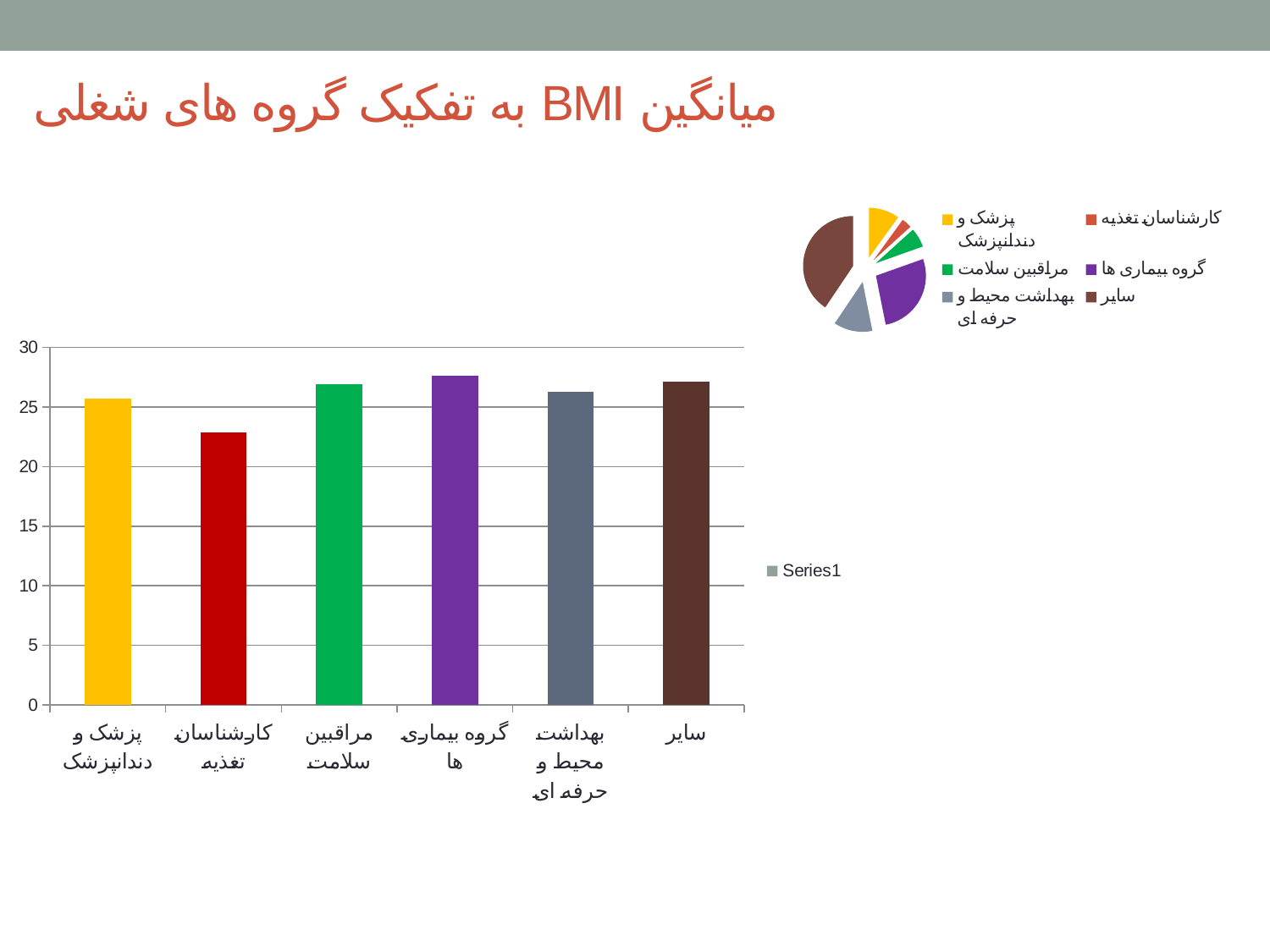
What is the title of the slide? میانگین BMI به تفکیک گروه های شغلی What kind of chart is the small chart in the upper right of the slide? pie chart In the bar chart, is the value for گروه بیماری ها greater or less than 25? greater In the bar chart, how many occupational groups are shown on the x axis? 6 In the bar chart, how many series does the legend list? 1 In the bar chart, which is larger: the value for کارشناسان تغذیه or the value for مراقبین سلامت? مراقبین سلامت In the pie chart, which legend entry corresponds to the largest slice? سایر In the bar chart, which is larger: the value for پزشک و دندانپزشک or the value for گروه بیماری ها? گروه بیماری ها In the bar chart, is the value for مراقبین سلامت greater or less than 25? greater What kind of chart is the large chart on the left of the slide? bar chart In the bar chart, which occupational group has the lowest mean BMI? کارشناسان تغذیه In the bar chart, is the value for کارشناسان تغذیه greater or less than 25? less